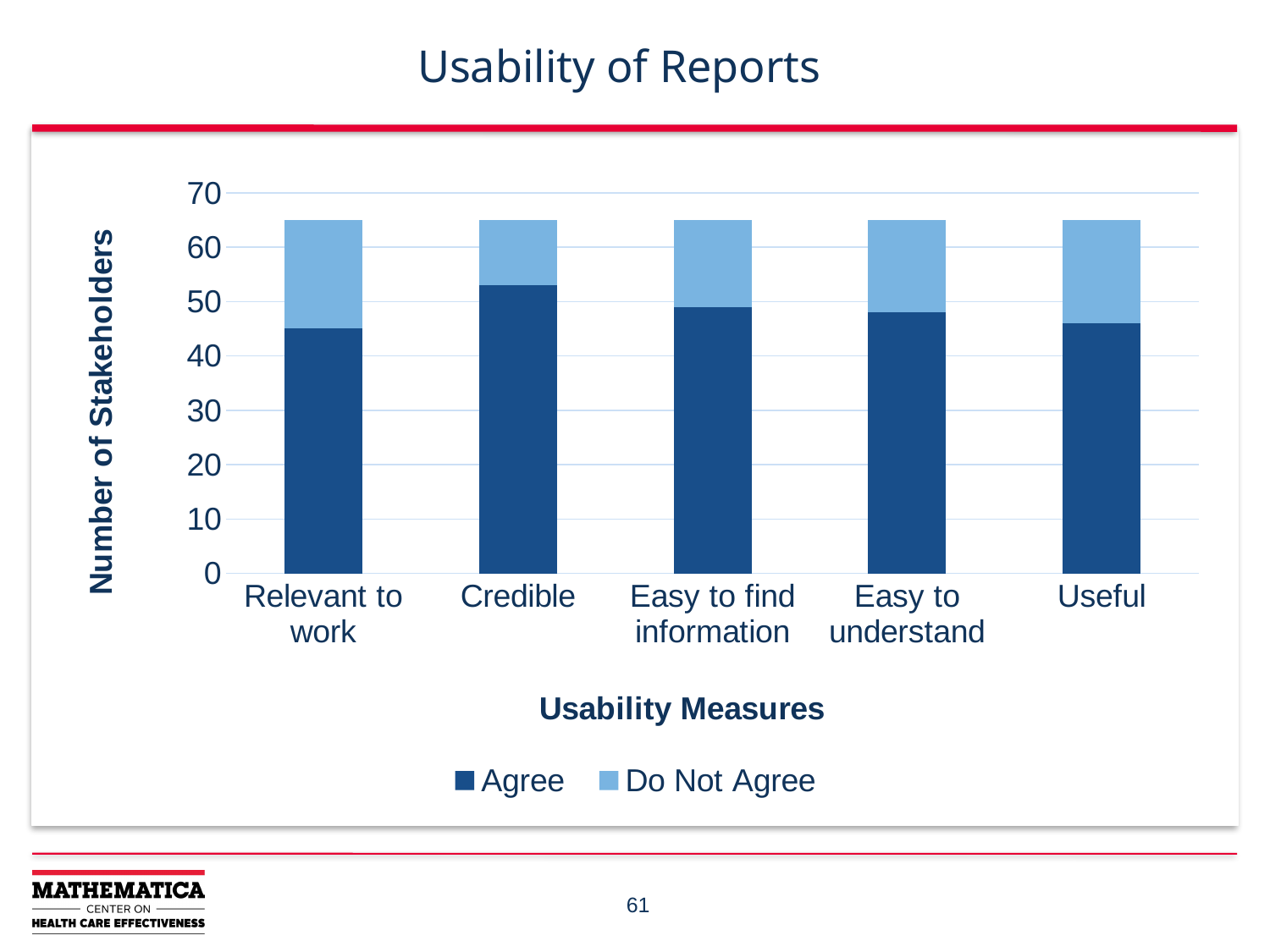
Which usability measure has the highest number of stakeholders who Agree? Credible What kind of chart is shown on the slide? stacked bar chart Is the Agree value for Useful greater or less than 50? less How many series does the legend list? 2 How many usability measures (categories) are shown on the x axis? 5 Which has more stakeholders who Do Not Agree, Relevant to work or Credible? Relevant to work Is the Agree value for Relevant to work greater or less than 50? less What is the label of the y axis? Number of Stakeholders Is the Do Not Agree value for Credible greater or less than 20? less Which has more stakeholders who Agree, Credible or Relevant to work? Credible